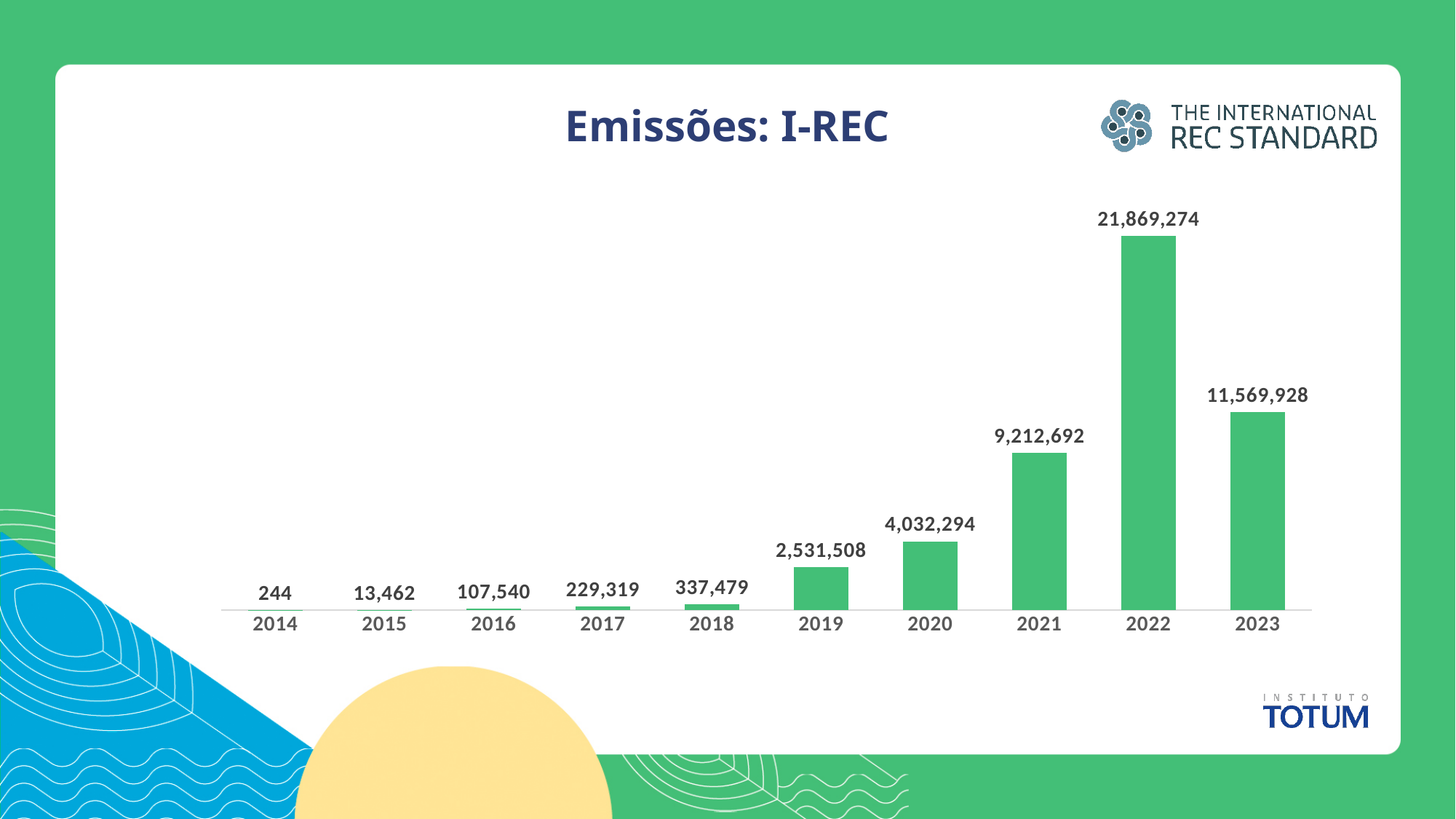
Do the values rise or fall from 2014 to 2022? Rise What is the difference between the values for 2022 and 2023? 10,299,346 What is the value for 2023? 11,569,928 What is the value for 2014? 244 Which year has the lowest value? 2014 What kind of chart is shown on the slide? Bar chart Which is larger, the value for 2021 or the value for 2023? 2023 How many years are shown on the x axis? 10 What is the value for 2019? 2,531,508 Which year has the highest value? 2022 What is the difference between the values for 2021 and 2020? 5,180,398 What is the value for 2022? 21,869,274